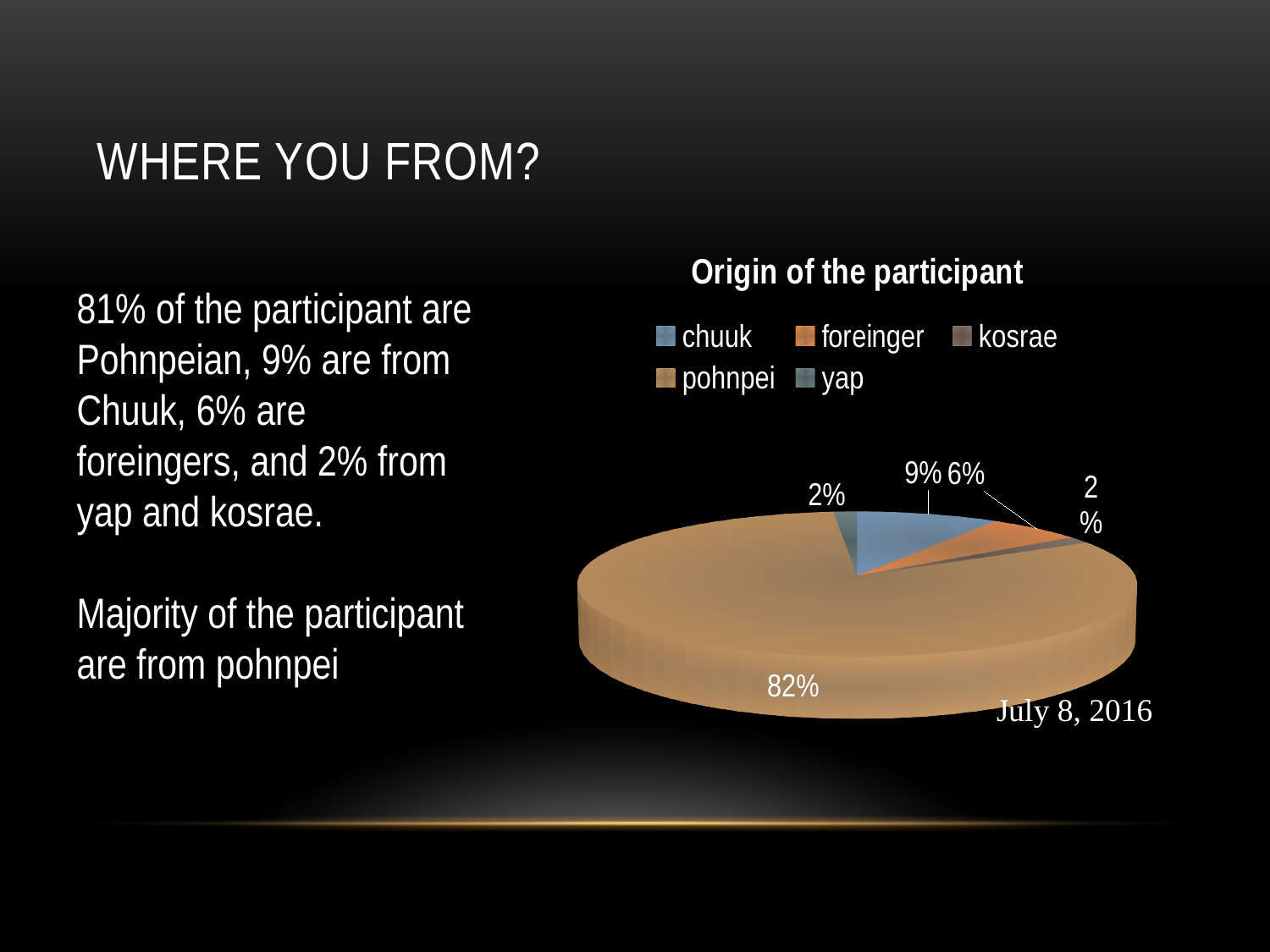
What percentage of participants are from chuuk? 9% What kind of chart is shown on the slide? pie chart What percentage of participants are from pohnpei according to the chart? 82% What percentage of participants are from kosrae? 2% What percentage of participants are from yap? 2% What is the title of the chart? Origin of the participant What share of the pie does the pohnpei slice represent? 82% What is the difference in percentage points between pohnpei and chuuk? 73 What percentage of participants are foreingers? 6% Which is larger, the share for chuuk or the share for foreinger? chuuk Which category has the largest slice of the pie? pohnpei How many categories does the pie chart's legend list? 5